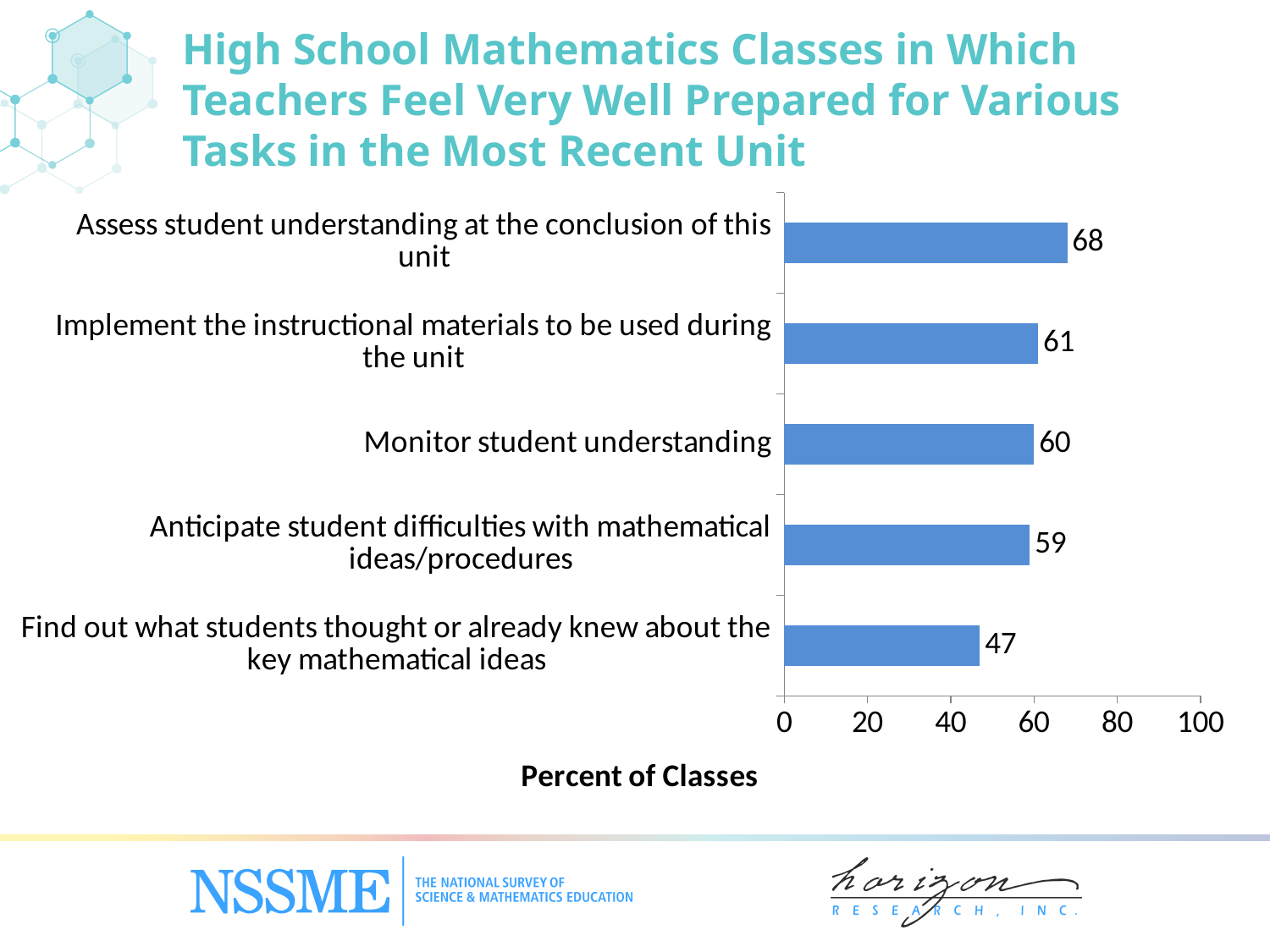
What is the label of the horizontal axis? Percent of Classes Which task has the highest percent of classes? Assess student understanding at the conclusion of this unit What is the difference between the values for "Implement the instructional materials to be used during the unit" and "Anticipate student difficulties with mathematical ideas/procedures"? 2 What is the value for "Monitor student understanding"? 60 What kind of chart is shown on the slide? bar chart What is the difference between the values for "Assess student understanding at the conclusion of this unit" and "Find out what students thought or already knew about the key mathematical ideas"? 21 Is the value for "Find out what students thought or already knew about the key mathematical ideas" greater or less than 60? less Which is larger: the value for "Assess student understanding at the conclusion of this unit" or the value for "Implement the instructional materials to be used during the unit"? Assess student understanding at the conclusion of this unit What is the value for "Assess student understanding at the conclusion of this unit"? 68 Which task has the lowest percent of classes? Find out what students thought or already knew about the key mathematical ideas What is the value for "Find out what students thought or already knew about the key mathematical ideas"? 47 How many tasks are shown in the chart? 5